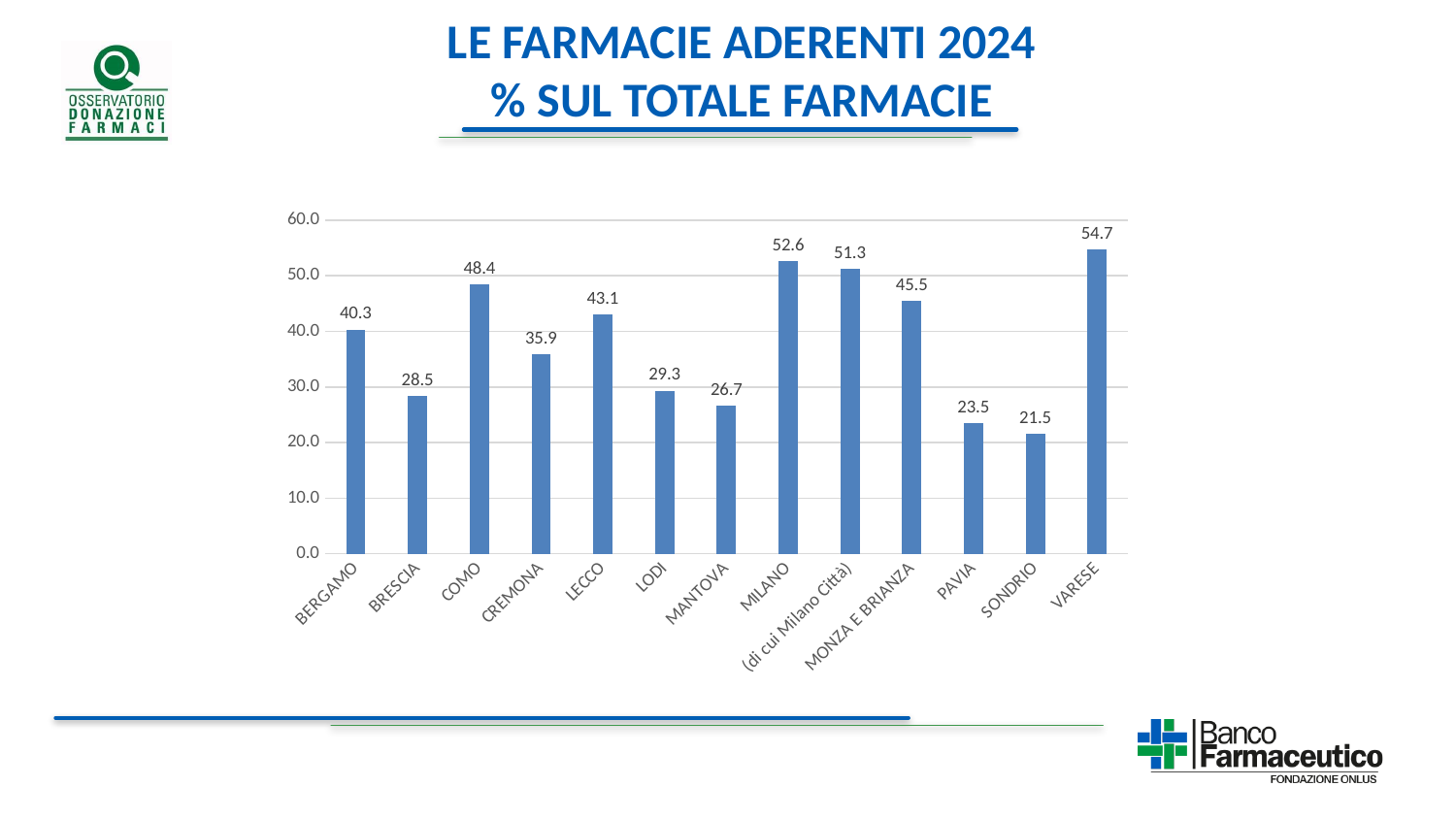
What is the value for BERGAMO? 40.3 What is the difference between the values for VARESE and PAVIA? 31.2 Which is larger, the value for COMO or the value for LECCO? COMO How many categories are shown on the x axis? 13 What is the value for SONDRIO? 21.5 Which category has the lowest value? SONDRIO What kind of chart is shown on the slide? bar chart What is the value for MONZA E BRIANZA? 45.5 Which category has the highest value? VARESE What is the difference between the values for MILANO and BRESCIA? 24.1 Is the value for CREMONA greater or less than 40.0? less What is the title of the chart on the slide? LE FARMACIE ADERENTI 2024 % SUL TOTALE FARMACIE